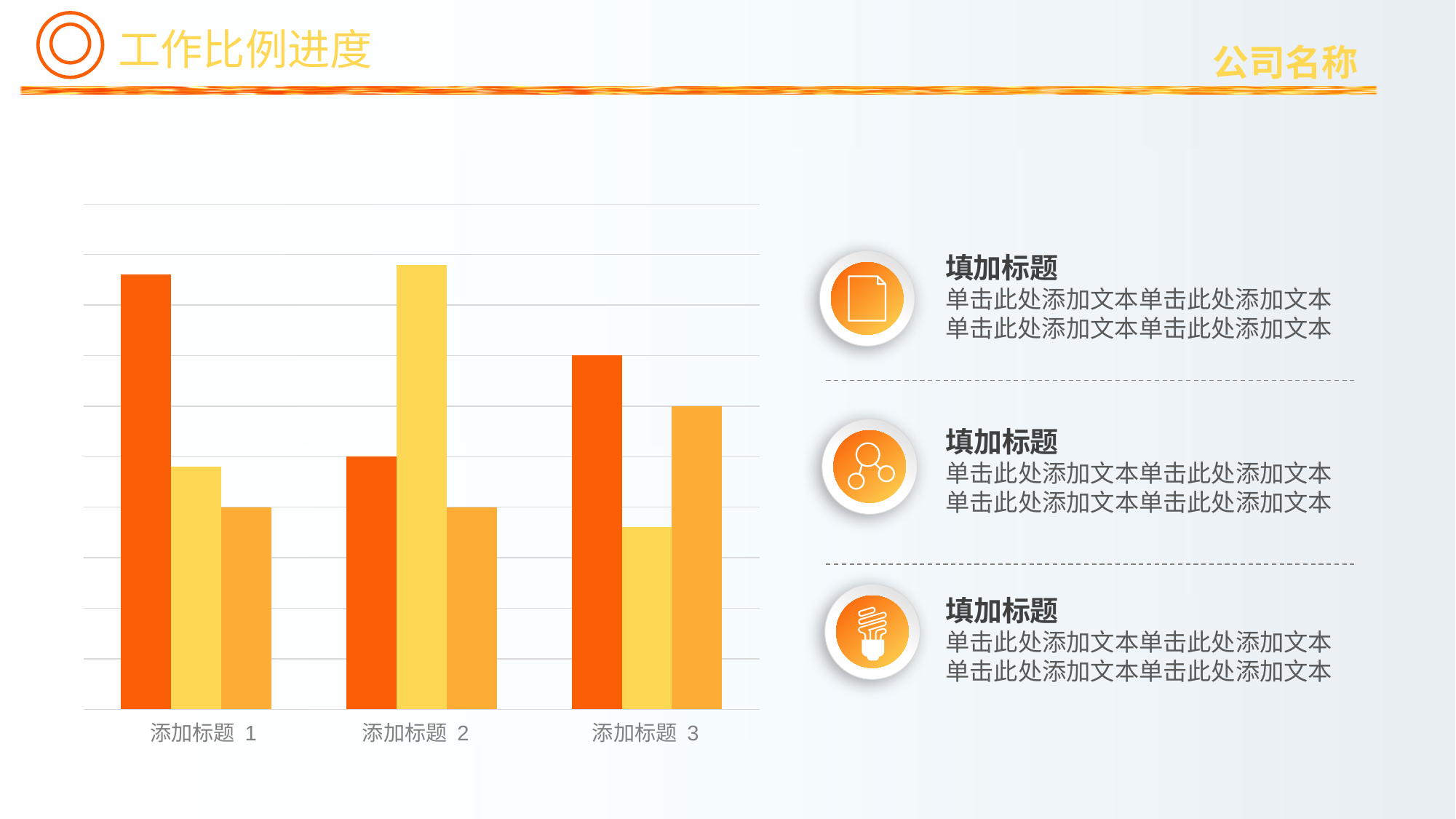
In the category 添加标题 3, which coloured bar is the shortest? yellow In the category 添加标题 2, which coloured bar is the tallest? yellow What kind of chart is shown on the slide? bar chart Is the dark orange bar taller for 添加标题 1 or for 添加标题 3? 添加标题 1 Which category has the tallest yellow bar? 添加标题 2 In the category 添加标题 1, which coloured bar is the tallest? dark orange Which category has the shortest dark orange bar? 添加标题 2 How many categories are shown on the x axis of the chart? 3 How many bars are plotted in the chart in total? 9 Does the chart display a legend? No